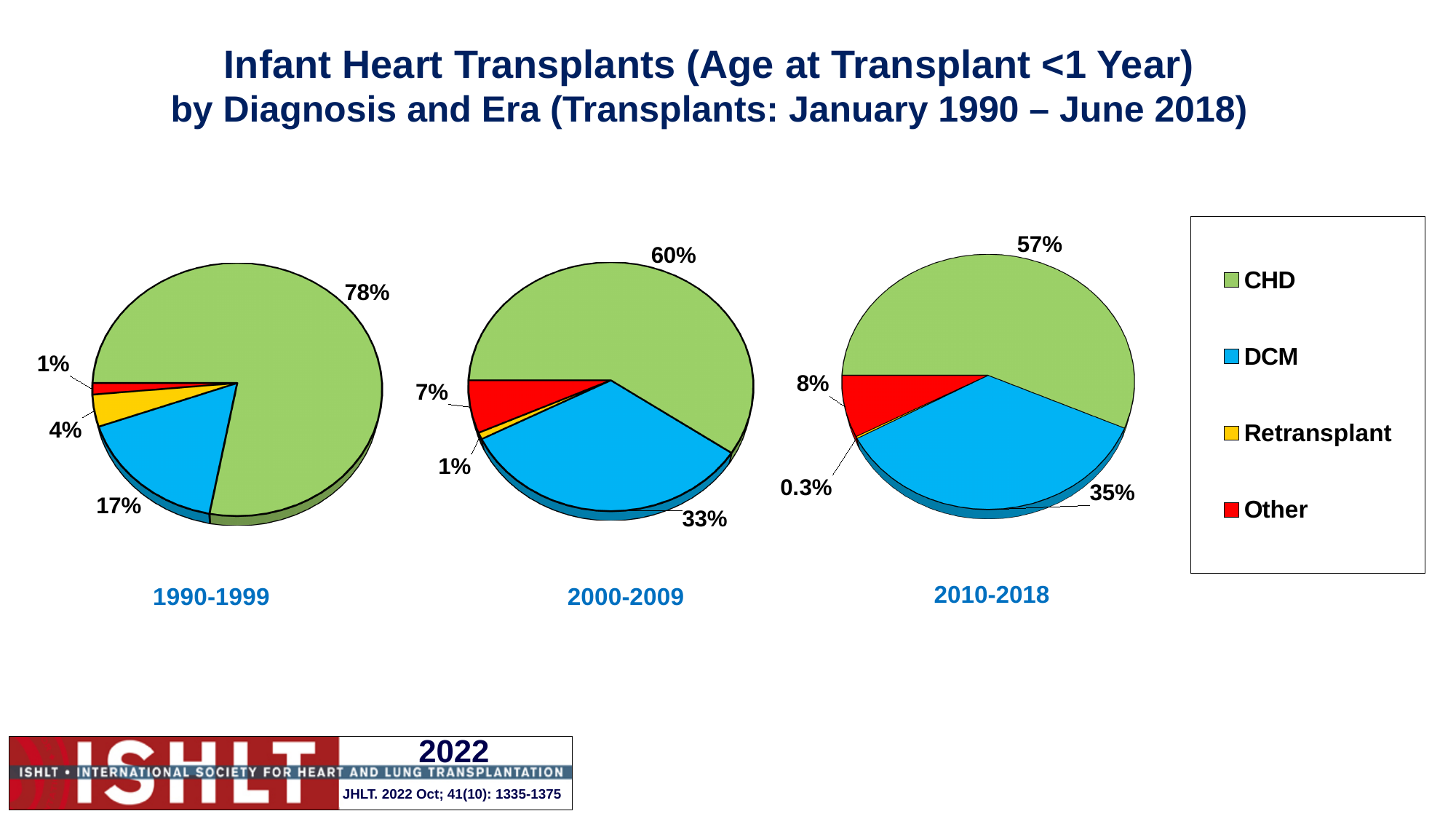
Which colour represents DCM in the legend? Blue In the 2010-2018 pie chart, what share of infant heart transplants was for Retransplant? 0.3% What is the difference between the CHD share in the 1990-1999 pie chart and the CHD share in the 2010-2018 pie chart? 21 percentage points In the 2000-2009 pie chart, what share of infant heart transplants was for DCM? 33% In the 1990-1999 pie chart, what share of infant heart transplants was for CHD? 78% In the 2010-2018 pie chart, what share of infant heart transplants was for Other? 8% What type of chart is used to show the 1990-1999 data? Pie chart How many slices does the 2000-2009 pie chart have? 4 In the 2000-2009 pie chart, which diagnosis has the largest share? CHD In the 2010-2018 pie chart, which is larger: the share for DCM or the share for Other? DCM How many diagnosis categories does the legend list? 4